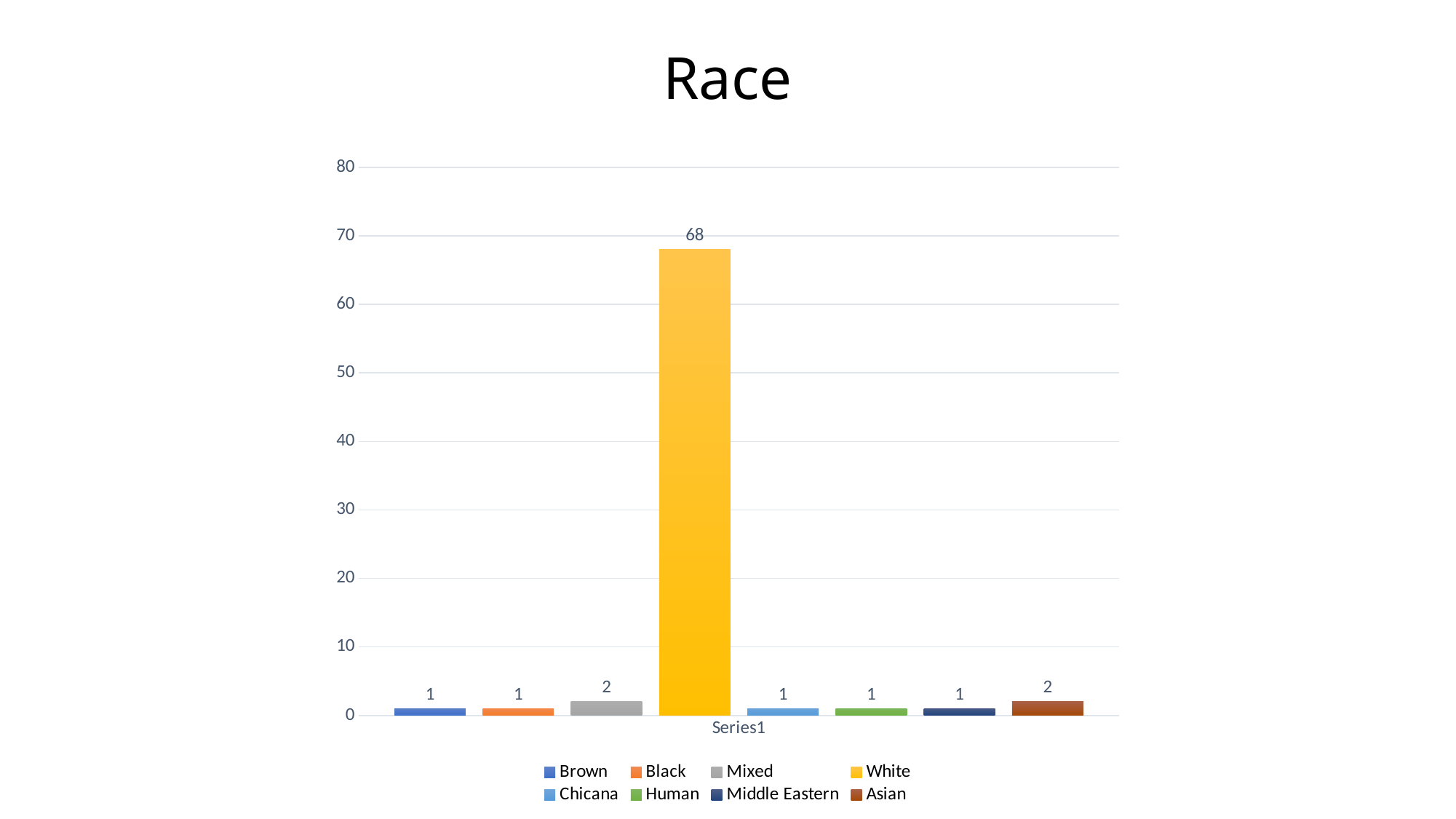
Which is larger, the value for Mixed or the value for Black? Mixed What is the value for Middle Eastern? 1 What is the value for White? 68 How many categories does the legend list? 8 What is the value for Asian? 2 What kind of chart is shown on the slide? bar chart What is the difference between the values for White and Mixed? 66 What is the value for Mixed? 2 What is the title of the chart? Race Is the value for White greater or less than 60? greater What is the difference between the values for Asian and Brown? 1 Which category has the highest value? White